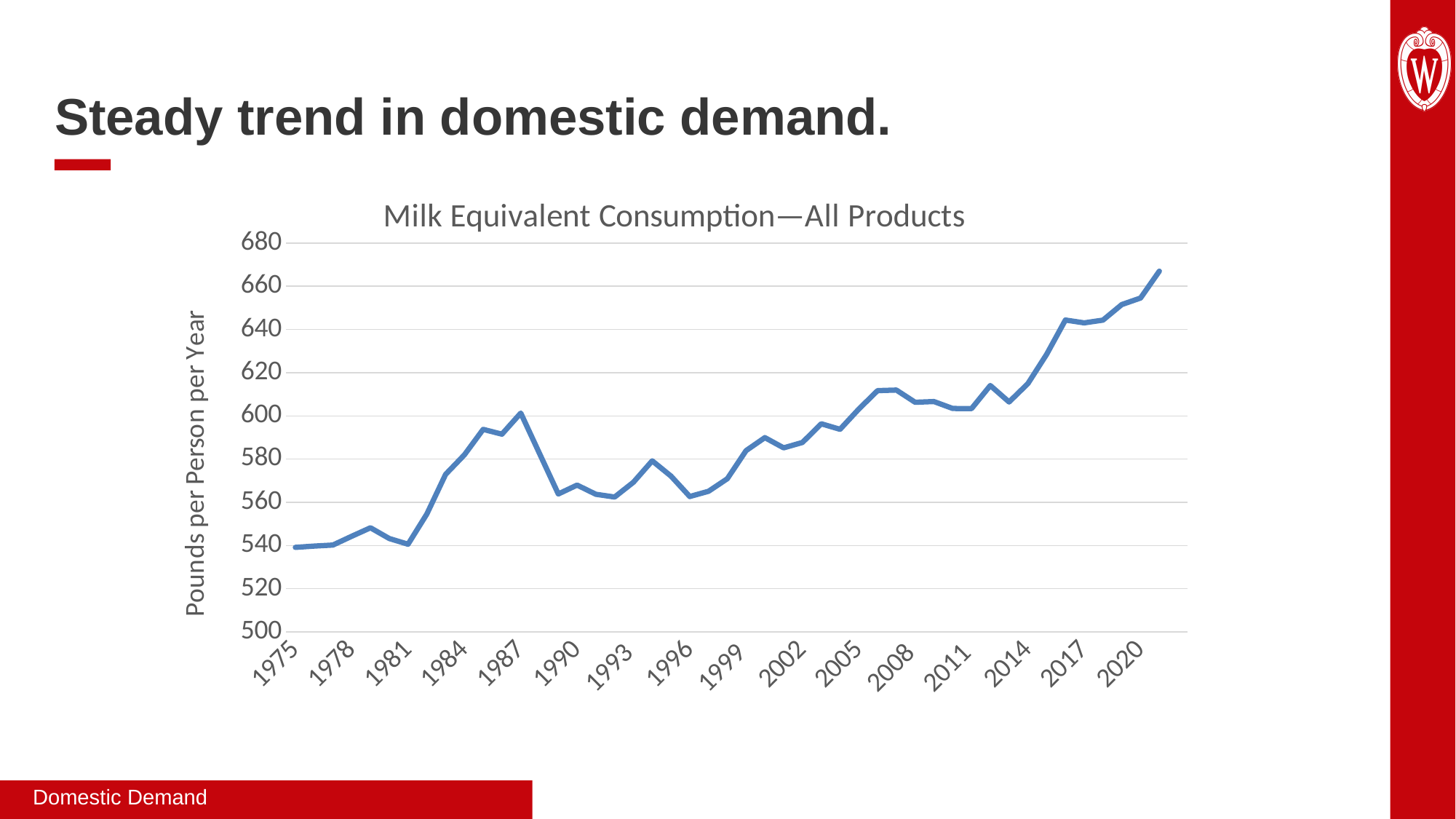
What is the title of the chart? Milk Equivalent Consumption—All Products Is the value for 1987 greater or less than 580? greater Is the value for 1975 greater or less than 560? less Is the value for 2008 greater or less than 600? greater Which year has the larger value, 1981 or 1984? 1984 Which year has the larger value, 1987 or 1990? 1987 What is the label on the vertical axis of the chart? Pounds per Person per Year What kind of chart is shown on the slide? line chart Overall, do the values rise or fall from 1975 to the end of the series? rise